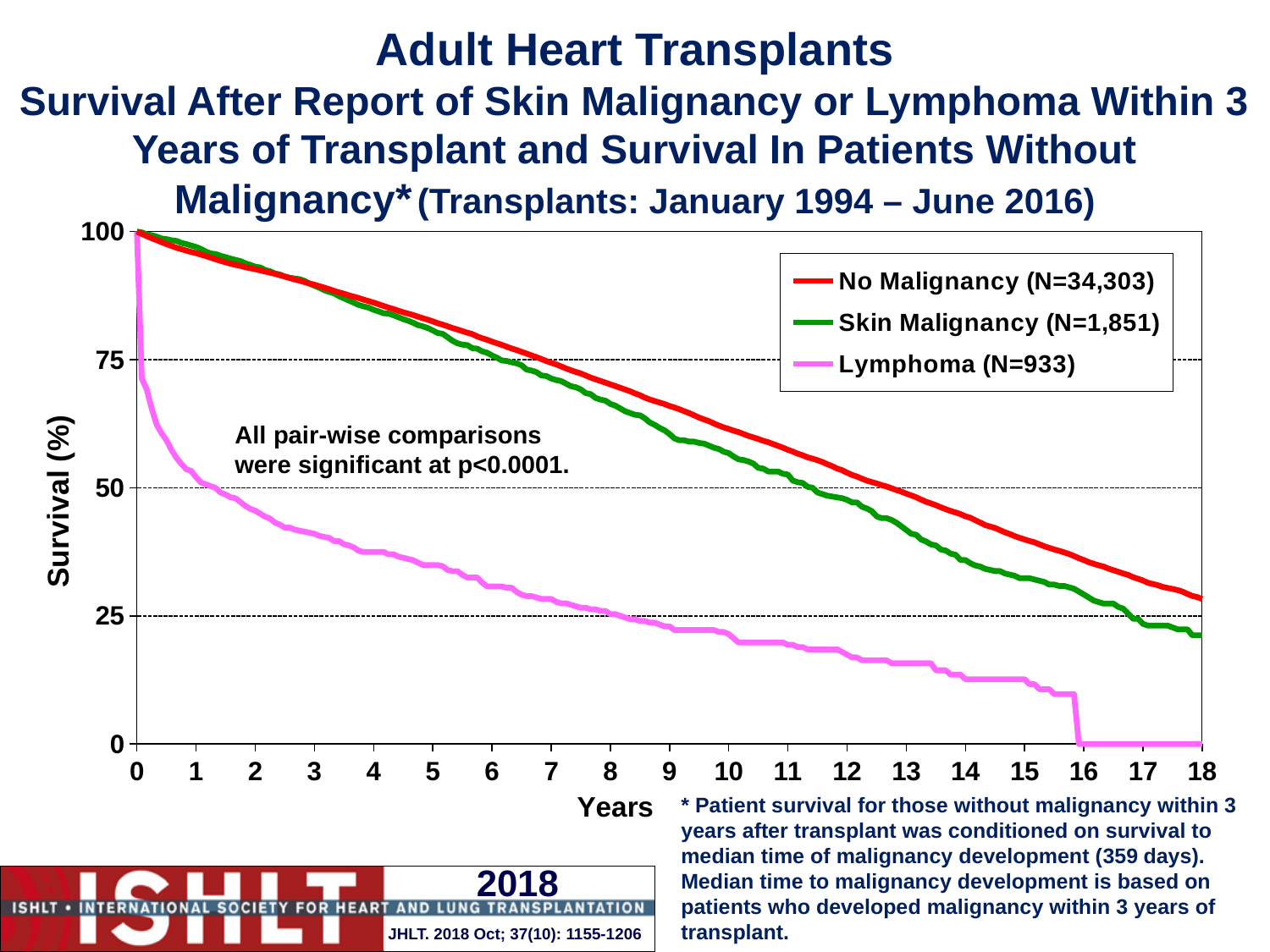
What colour is the line for the Skin Malignancy group? Green Which group has the lowest survival at 5 years? Lymphoma Is the survival value for Lymphoma at 5 years greater or less than 25? greater At 10 years, which is larger: survival for No Malignancy or for Lymphoma? No Malignancy How many series does the legend list? 3 Do the survival curves rise or fall as years since transplant increase? Fall Which group has the highest survival at 15 years? No Malignancy Is the survival value for No Malignancy at 12 years greater or less than 50? greater What kind of chart is shown on the slide? Line chart Is the survival value for Skin Malignancy at 18 years greater or less than 25? less What is the N reported in the legend for the Lymphoma group? N=933